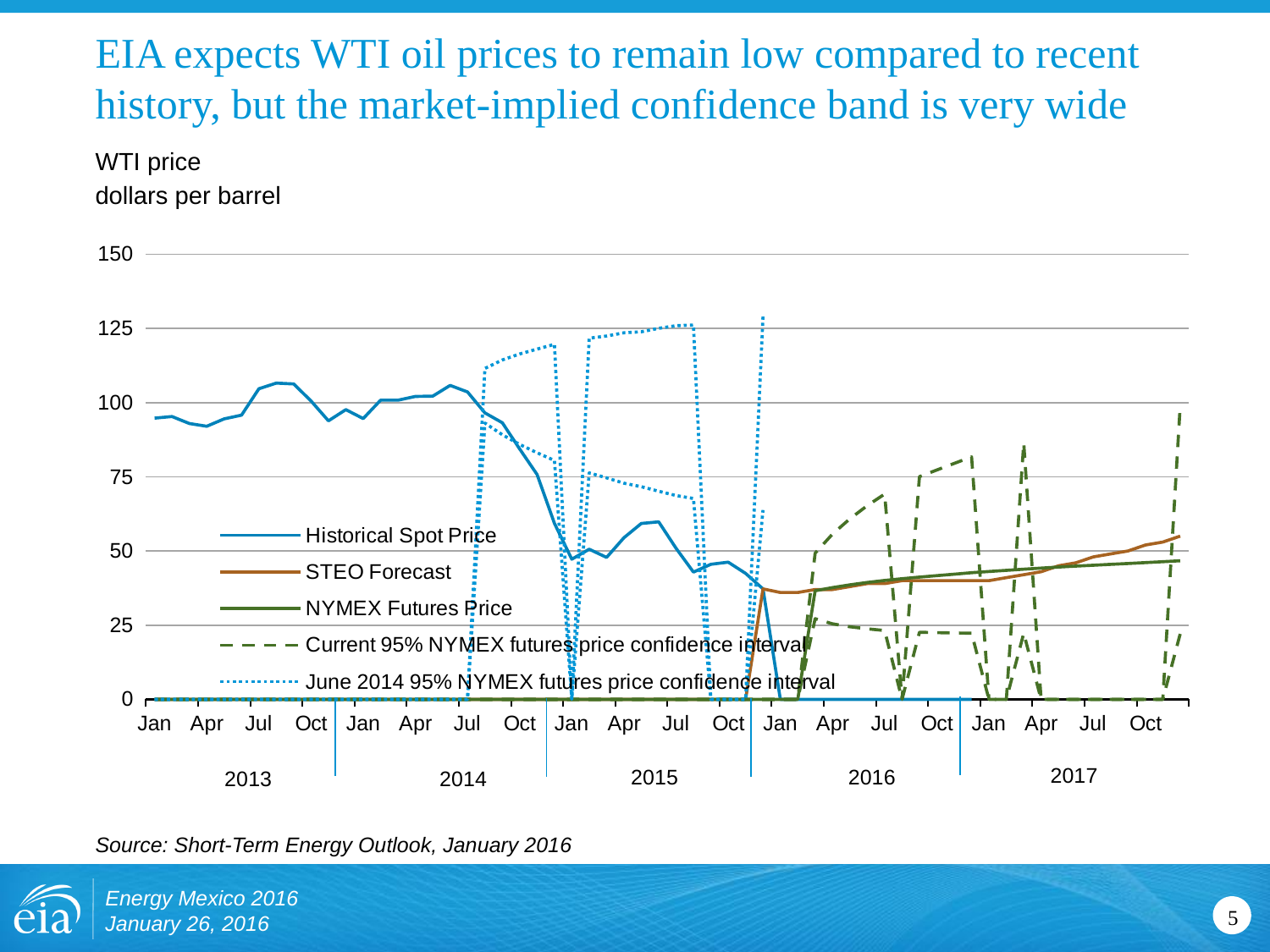
What is the highest value shown on the y axis? 150 Which is larger: the Historical Spot Price in January 2013 or the Historical Spot Price in December 2015? January 2013 How many years are labelled along the x axis? 5 What kind of chart is shown on the slide? line chart What unit is the WTI price plotted in, according to the axis label? dollars per barrel Is the NYMEX Futures Price in early 2016 greater or less than 50? less Is the Historical Spot Price at the end of 2015 greater or less than 50? less Does the Historical Spot Price rise or fall between mid-2014 and the end of 2015? fall Is the Historical Spot Price in January 2013 greater or less than 75? greater How many series does the legend list? 5 Which series is drawn as a dotted line in the legend? June 2014 95% NYMEX futures price confidence interval